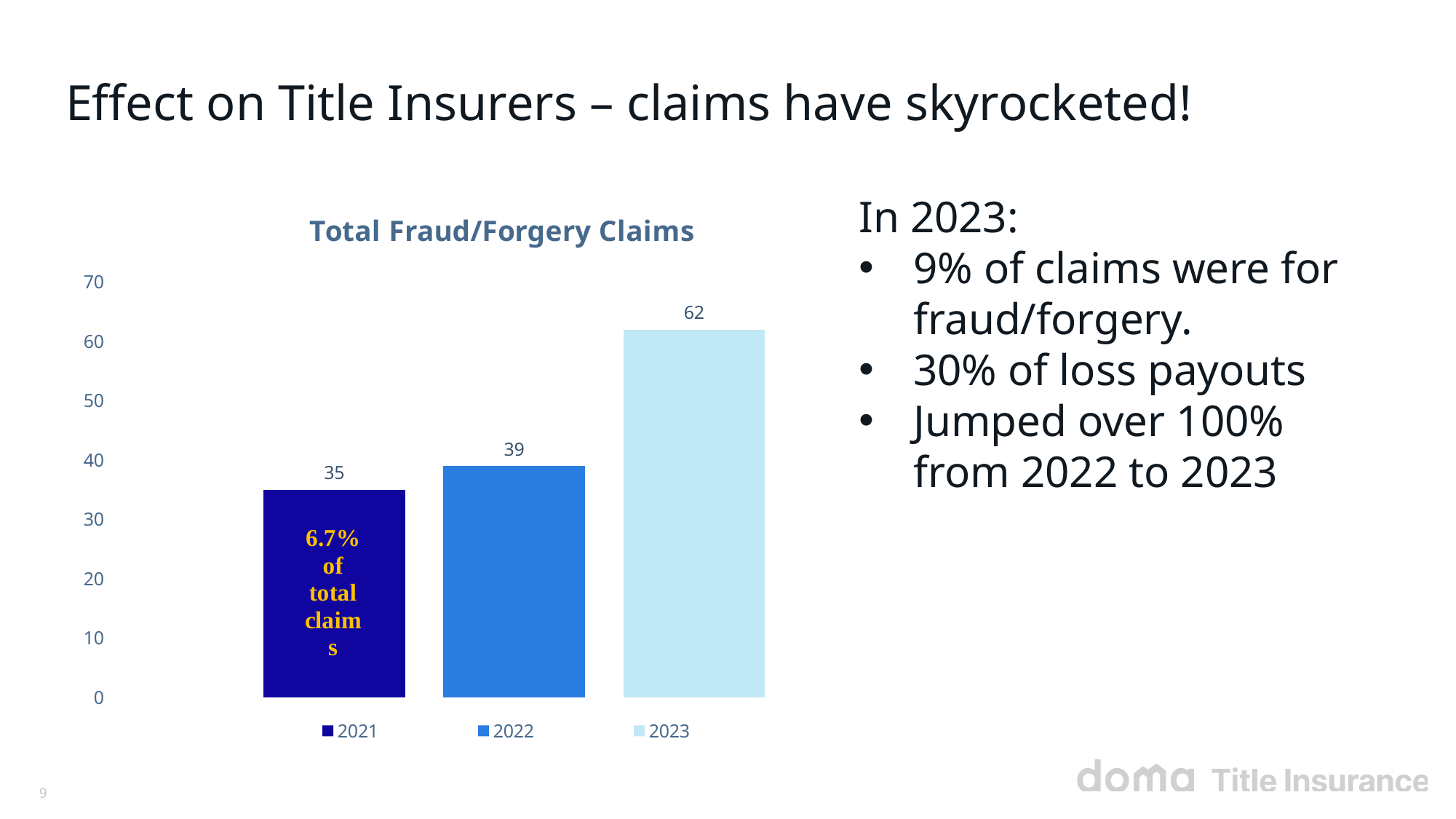
Do the values rise or fall from 2021 to 2023 in the chart? Rise What kind of chart is shown on the slide? Bar chart What is the value for 2022 in the Total Fraud/Forgery Claims chart? 39 What is the difference between the 2022 and 2021 values in the chart? 4 How many bars are shown in the Total Fraud/Forgery Claims chart? 3 Which is larger, the value for 2021 or the value for 2023? 2023 Which year has the lowest number of fraud/forgery claims? 2021 What is the value for 2023 in the Total Fraud/Forgery Claims chart? 62 What is the title of the chart on the slide? Total Fraud/Forgery Claims What is the difference between the 2023 and 2022 values in the chart? 23 What is the value for 2021 in the Total Fraud/Forgery Claims chart? 35 Which year has the highest number of fraud/forgery claims? 2023